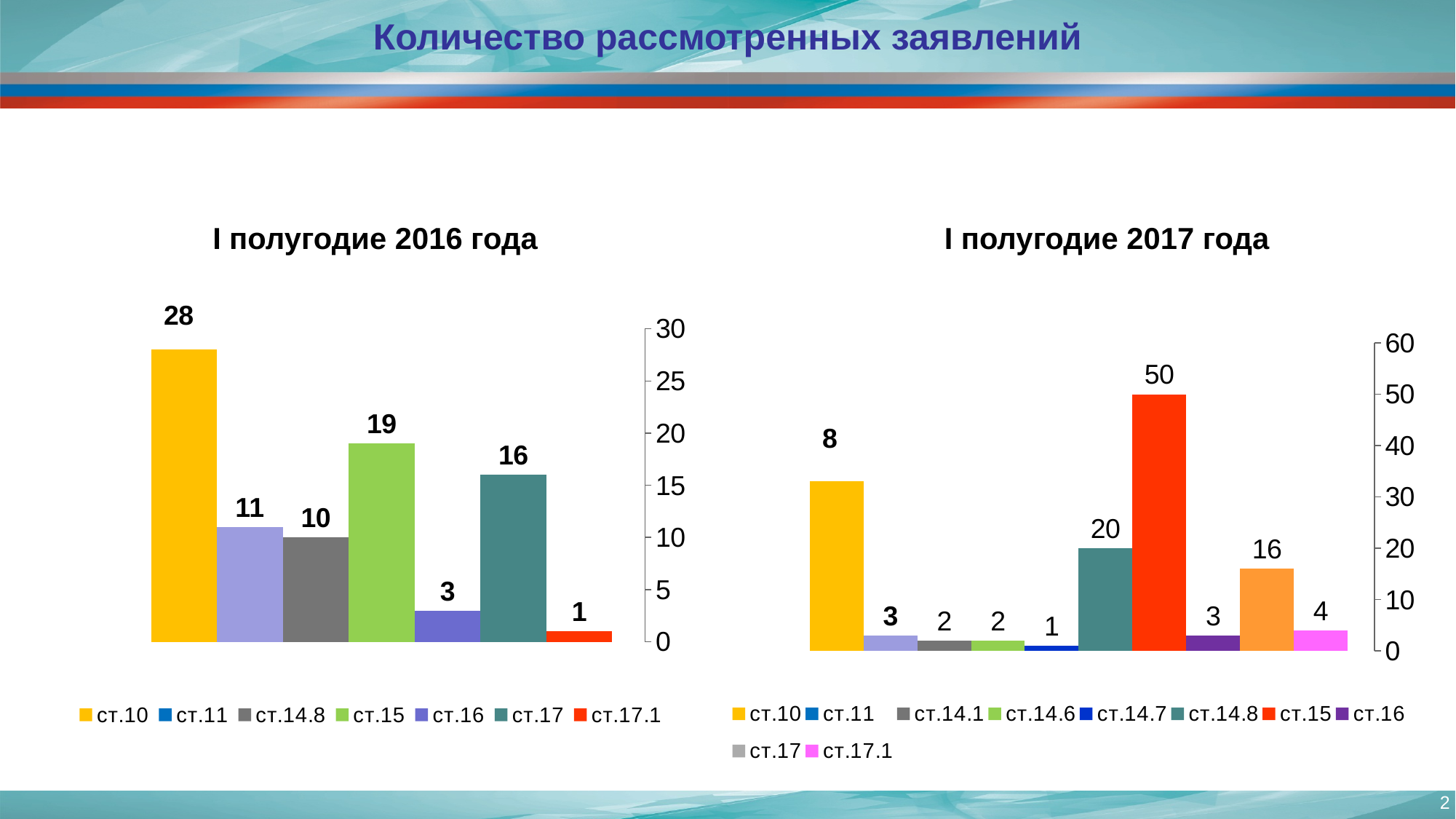
In the chart titled 'I полугодие 2016 года', what is the value for ст.15? 19 In the chart titled 'I полугодие 2017 года', what is the difference between the values for ст.15 and ст.14.8? 30 In the chart titled 'I полугодие 2016 года', what is the value for ст.10? 28 In the chart titled 'I полугодие 2017 года', what is the value for ст.15? 50 In the chart titled 'I полугодие 2016 года', which series has the lowest value? ст.17.1 In the chart titled 'I полугодие 2017 года', which series has the highest value? ст.15 In the chart titled 'I полугодие 2017 года', which is larger, the value for ст.17 or the value for ст.17.1? ст.17 In the chart titled 'I полугодие 2017 года', how many series does the legend list? 10 In the chart titled 'I полугодие 2016 года', what is the difference between the values for ст.10 and ст.17? 12 In the chart titled 'I полугодие 2016 года', how many series does the legend list? 7 What kind of chart is the chart titled 'I полугодие 2017 года'? bar chart In the chart titled 'I полугодие 2017 года', what is the value for ст.14.8? 20